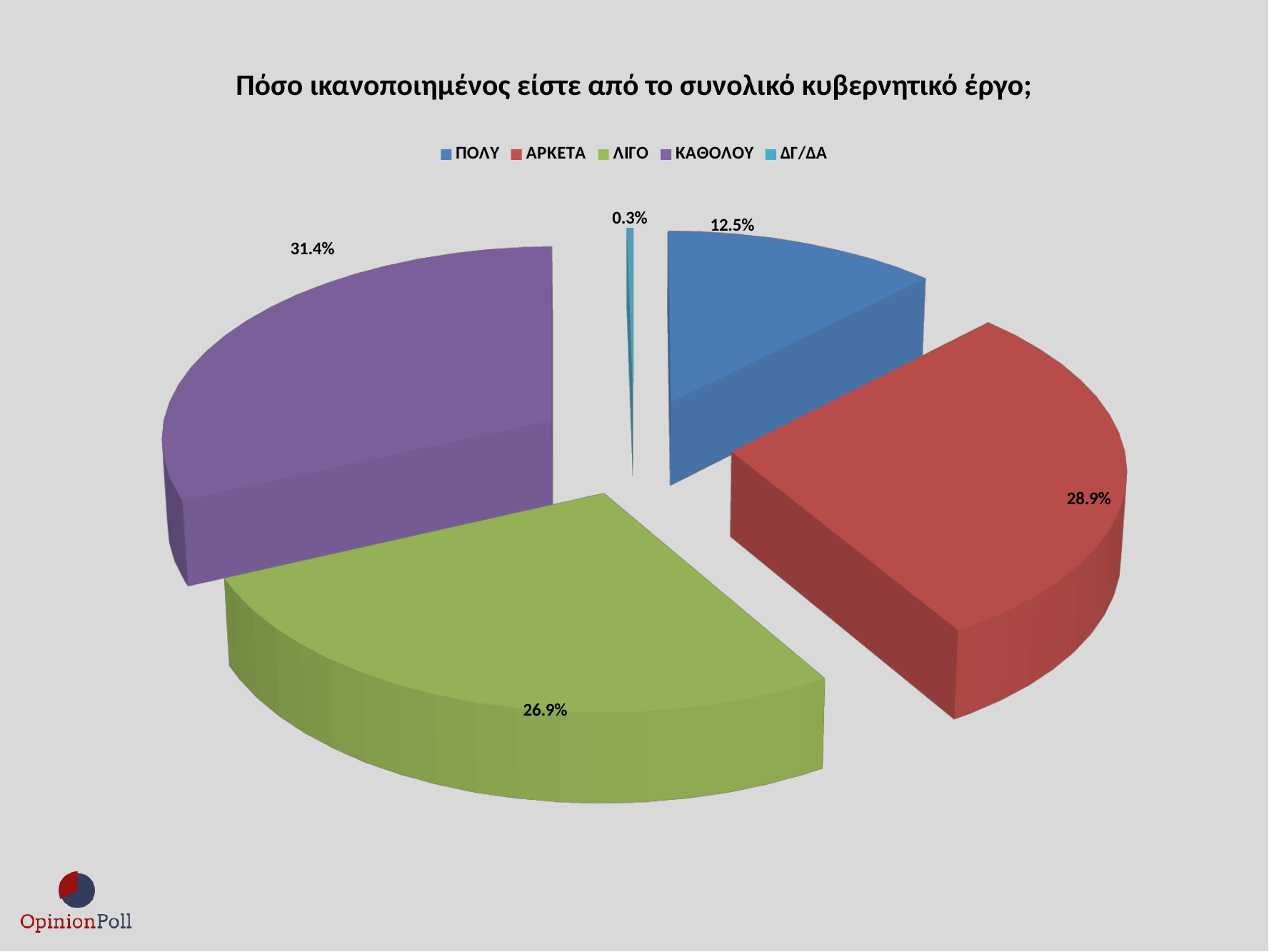
How many categories does the pie chart show? 5 What share of the pie does ΛΙΓΟ have? 26.9% What share of the pie does ΑΡΚΕΤΑ have? 28.9% What is the difference in percentage points between ΚΑΘΟΛΟΥ and ΠΟΛΥ? 18.9 What share of the pie does ΔΓ/ΔΑ have? 0.3% What colour is the slice for ΛΙΓΟ? Green What share of the pie does ΚΑΘΟΛΟΥ have? 31.4% What share of the pie does ΠΟΛΥ have? 12.5% Which is larger, ΑΡΚΕΤΑ or ΛΙΓΟ? ΑΡΚΕΤΑ Which category has the smallest slice of the pie? ΔΓ/ΔΑ Which category has the largest slice of the pie? ΚΑΘΟΛΟΥ What kind of chart is shown on the slide? Pie chart